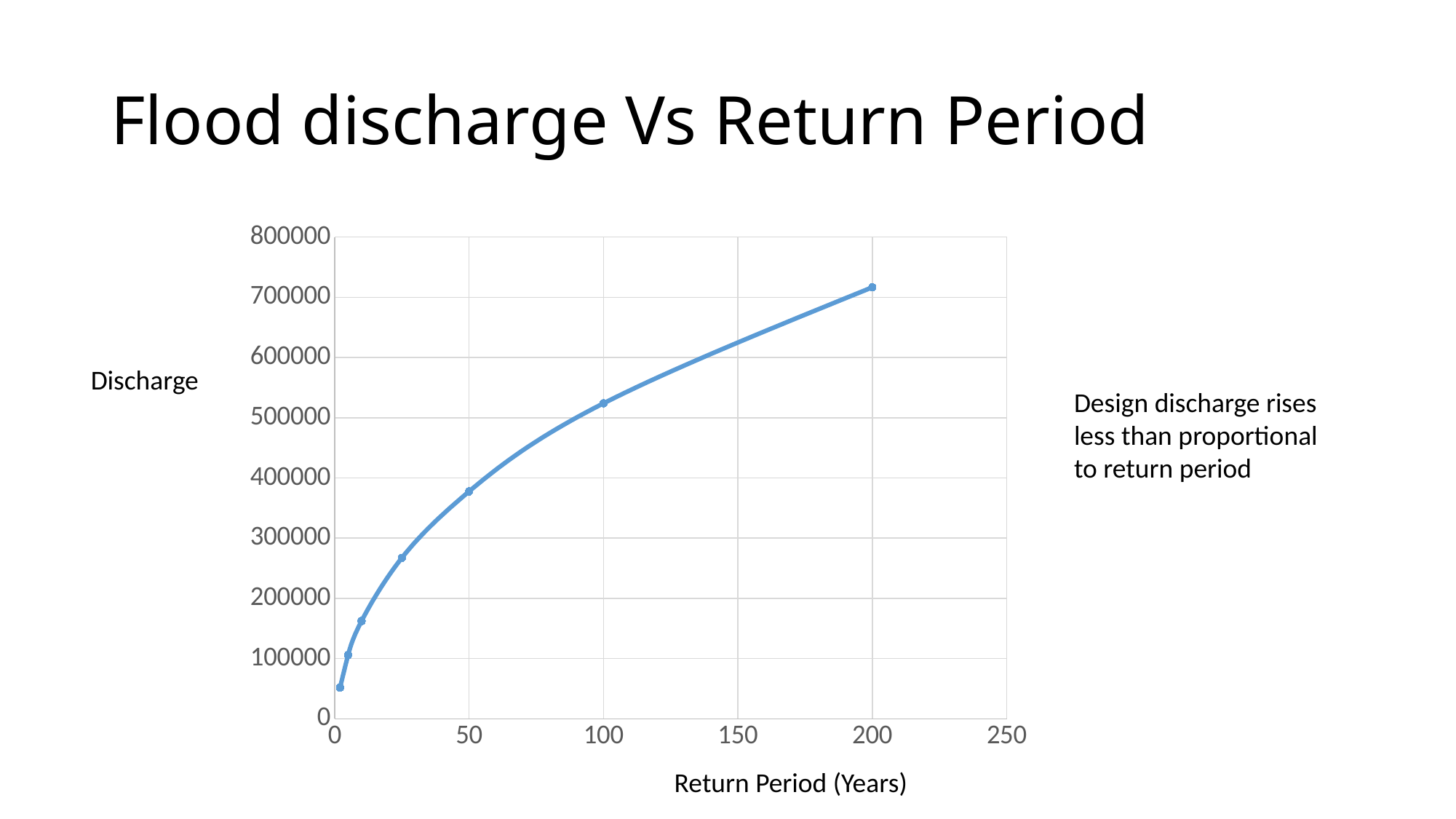
What is the label of the x axis? Return Period (Years) What kind of chart is shown on the slide? line chart Is the discharge at a return period of 100 years greater or less than 600000? less What is the title of the chart on the slide? Flood discharge Vs Return Period Is the discharge at a return period of 50 years greater or less than 400000? less Is the discharge at a return period of 100 years greater or less than 500000? greater Does discharge rise or fall as the return period increases? rises Which return period has the highest discharge? 200 Which is larger, the discharge at a return period of 100 years or at 50 years? 100 years How many data points are plotted on the line? 7